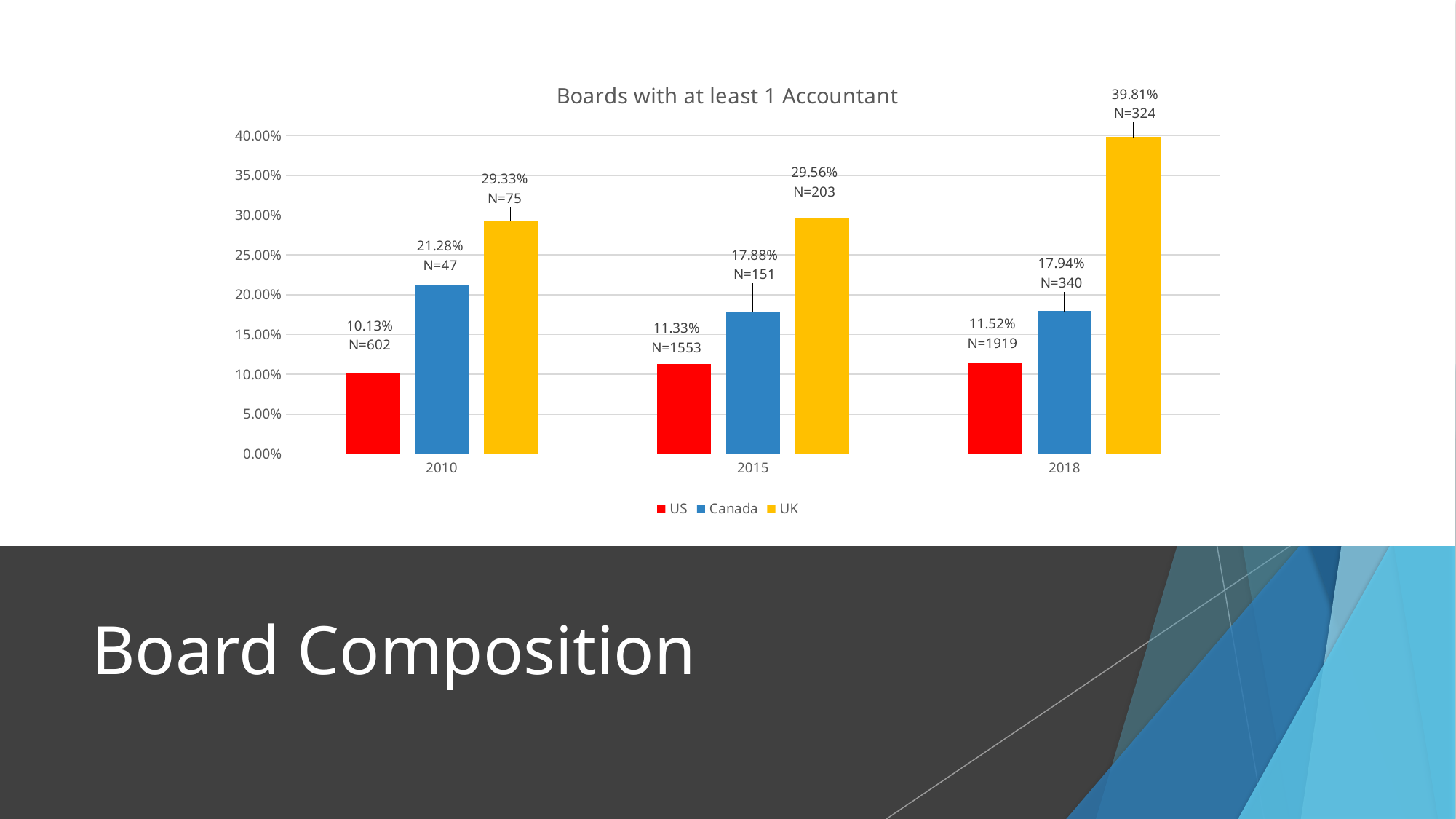
What is the difference between the UK and Canada values in 2010? 8.05% What is the value for the US in 2010? 10.13% Which is larger, the Canada value in 2010 or the Canada value in 2018? Canada in 2010 How many series does the legend list? 3 What is the value for Canada in 2015? 17.88% What is the value for the UK in 2018? 39.81% How many years are shown on the x axis? 3 What kind of chart is this? Bar chart What is the N shown for the US in 2018? N=1919 Which country has the lowest value in 2010? US Do the US values rise or fall from 2010 to 2018? Rise Which country has the highest value in 2018? UK